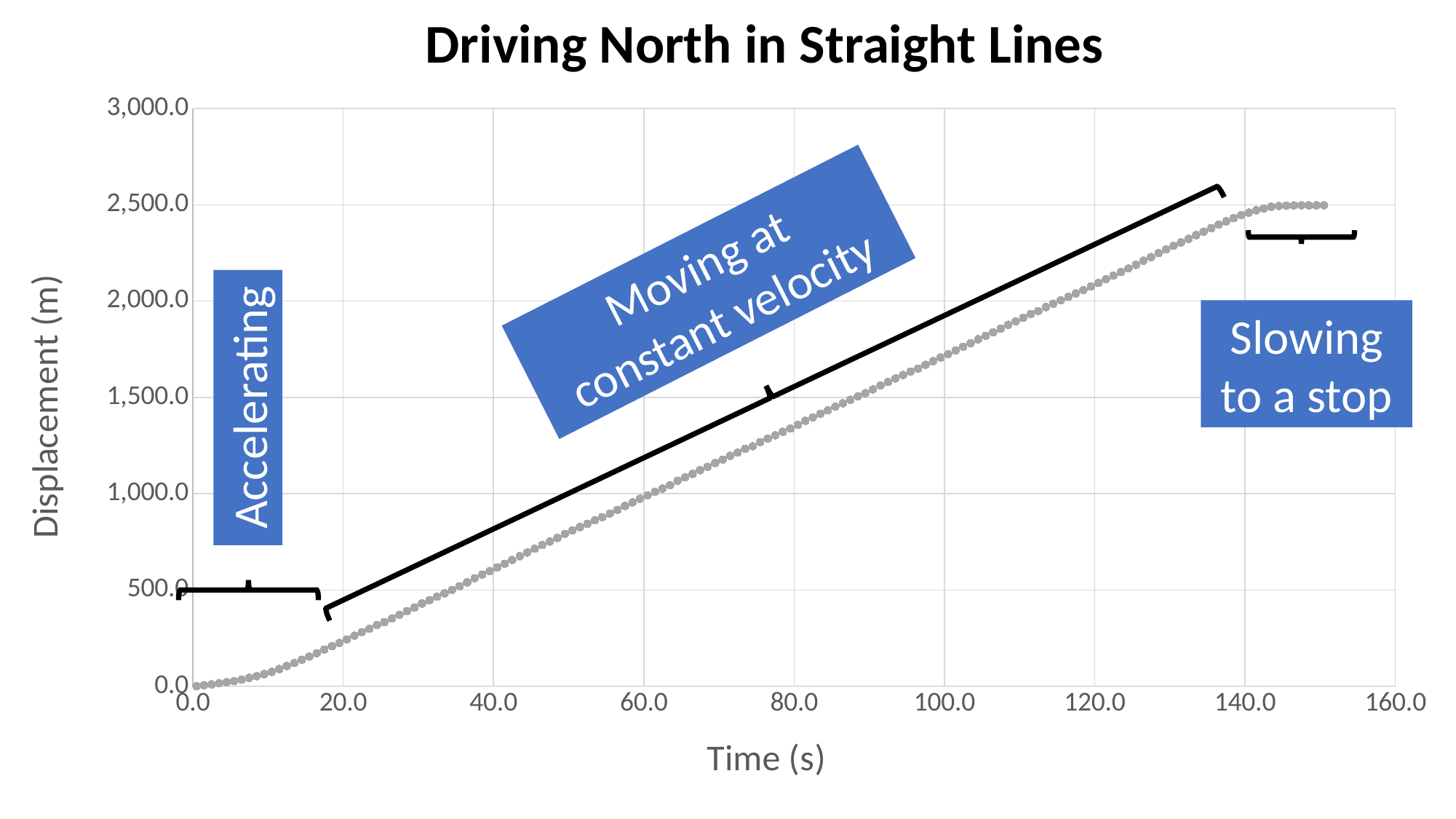
Is the final displacement reached at the end of the plotted data greater or less than 2,000.0 m? greater Is the displacement at 40.0 s greater or less than 1,000.0 m? less Is the displacement at 60.0 s greater or less than 1,500.0 m? less What are the three motion phases labelled on the chart? Accelerating, Moving at constant velocity, Slowing to a stop Does displacement rise or fall as time increases along the x axis? rise What is the highest value shown on the y axis? 3,000.0 What kind of chart is shown on the slide? scatter chart What is the title of the chart? Driving North in Straight Lines What is the highest value shown on the x axis? 160.0